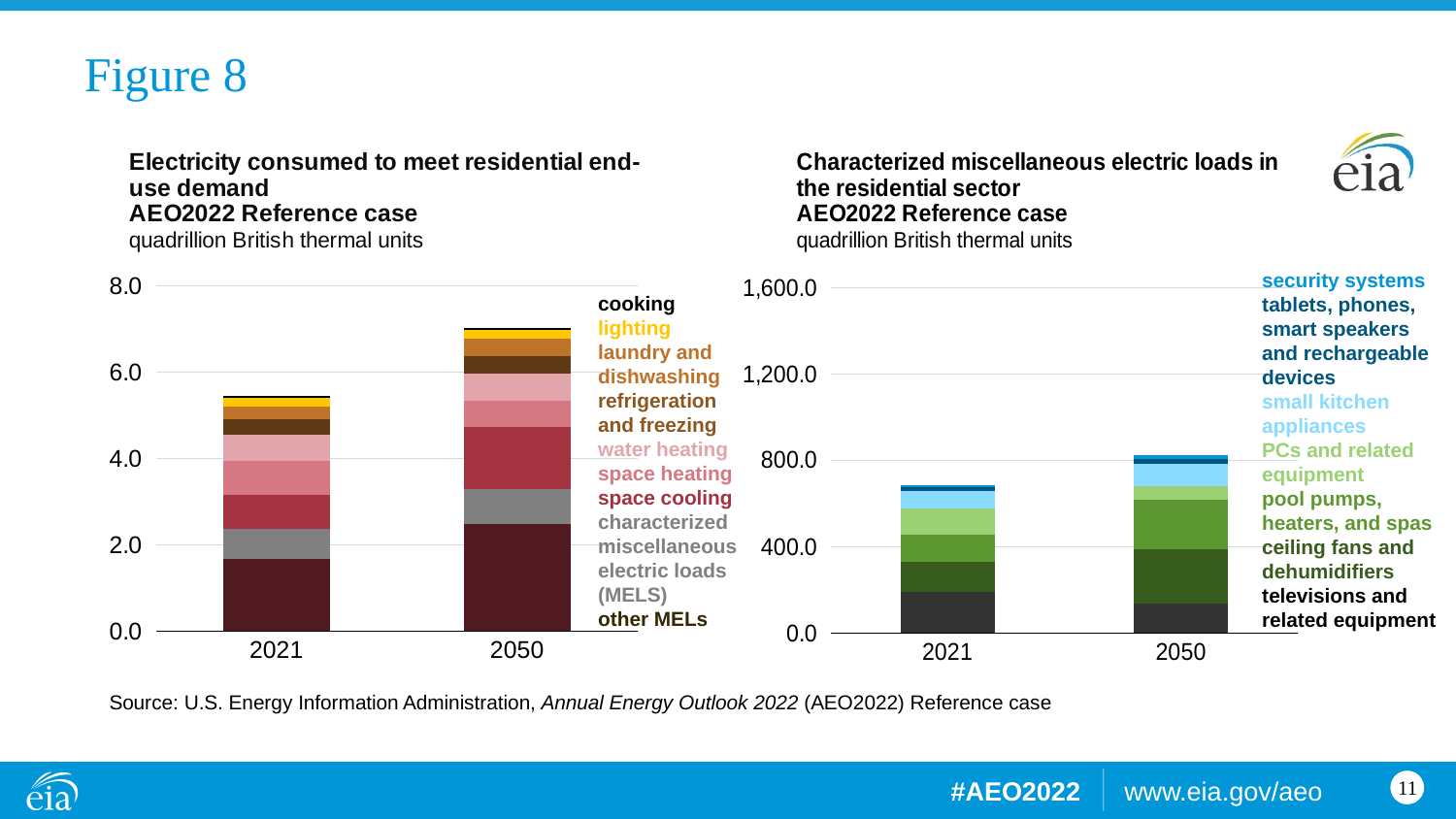
In the left chart, 'Electricity consumed to meet residential end-use demand', does total electricity consumption rise or fall from 2021 to 2050? rise In the left chart, 'Electricity consumed to meet residential end-use demand', is the total for 2021 greater or less than 4.0? greater In the left chart, 'Electricity consumed to meet residential end-use demand', is the total for 2050 greater or less than 6.0? greater What unit of measurement is stated under the title of the left chart, 'Electricity consumed to meet residential end-use demand'? quadrillion British thermal units In the right chart, 'Characterized miscellaneous electric loads in the residential sector', is the total for 2050 greater or less than 400.0? greater How many series does the legend of the right chart, 'Characterized miscellaneous electric loads in the residential sector', list? 7 In the right chart, 'Characterized miscellaneous electric loads in the residential sector', which year has the larger total bar, 2021 or 2050? 2050 In the left chart, 'Electricity consumed to meet residential end-use demand', which year has the larger total bar, 2021 or 2050? 2050 How many series does the legend of the left chart, 'Electricity consumed to meet residential end-use demand', list? 9 How many categories are shown on the x axis of the left chart, 'Electricity consumed to meet residential end-use demand'? 2 What type of chart is the left chart, 'Electricity consumed to meet residential end-use demand'? stacked bar chart